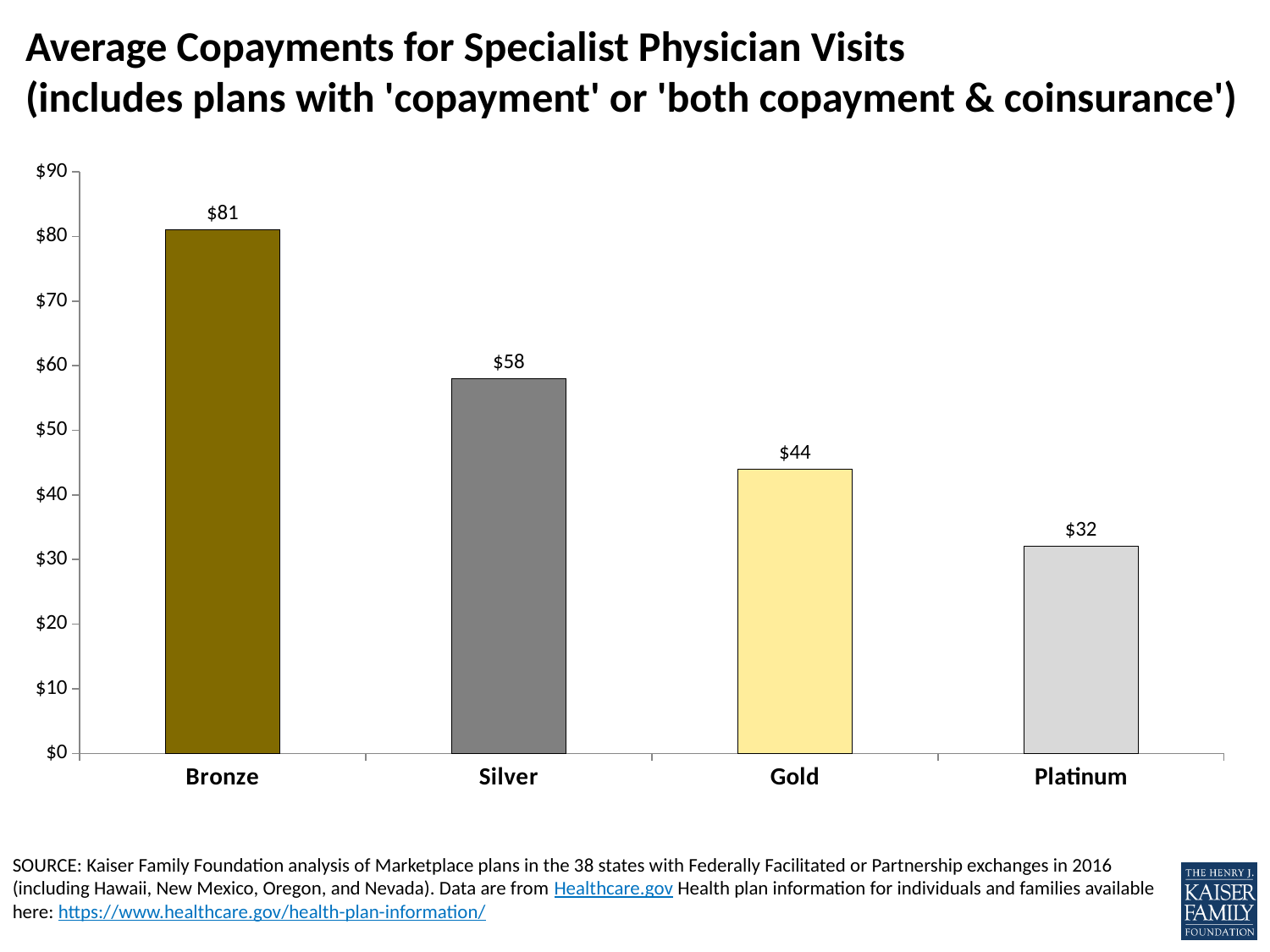
What kind of chart is shown on the slide? Bar chart What is the average copayment for specialist physician visits for Gold plans? $44 Which plan type has the highest average copayment for specialist physician visits? Bronze What is the average copayment for specialist physician visits for Silver plans? $58 What is the average copayment for specialist physician visits for Bronze plans? $81 Which plan type has the lowest average copayment for specialist physician visits? Platinum Do the average copayments rise or fall moving from Bronze to Platinum along the x axis? Fall Which has a larger average copayment for specialist physician visits, Silver or Gold? Silver How many plan types are shown in the chart? 4 What is the difference between the average copayment for Bronze plans and Platinum plans? $49 What is the average copayment for specialist physician visits for Platinum plans? $32 What is the difference between the average copayment for Silver plans and Gold plans? $14